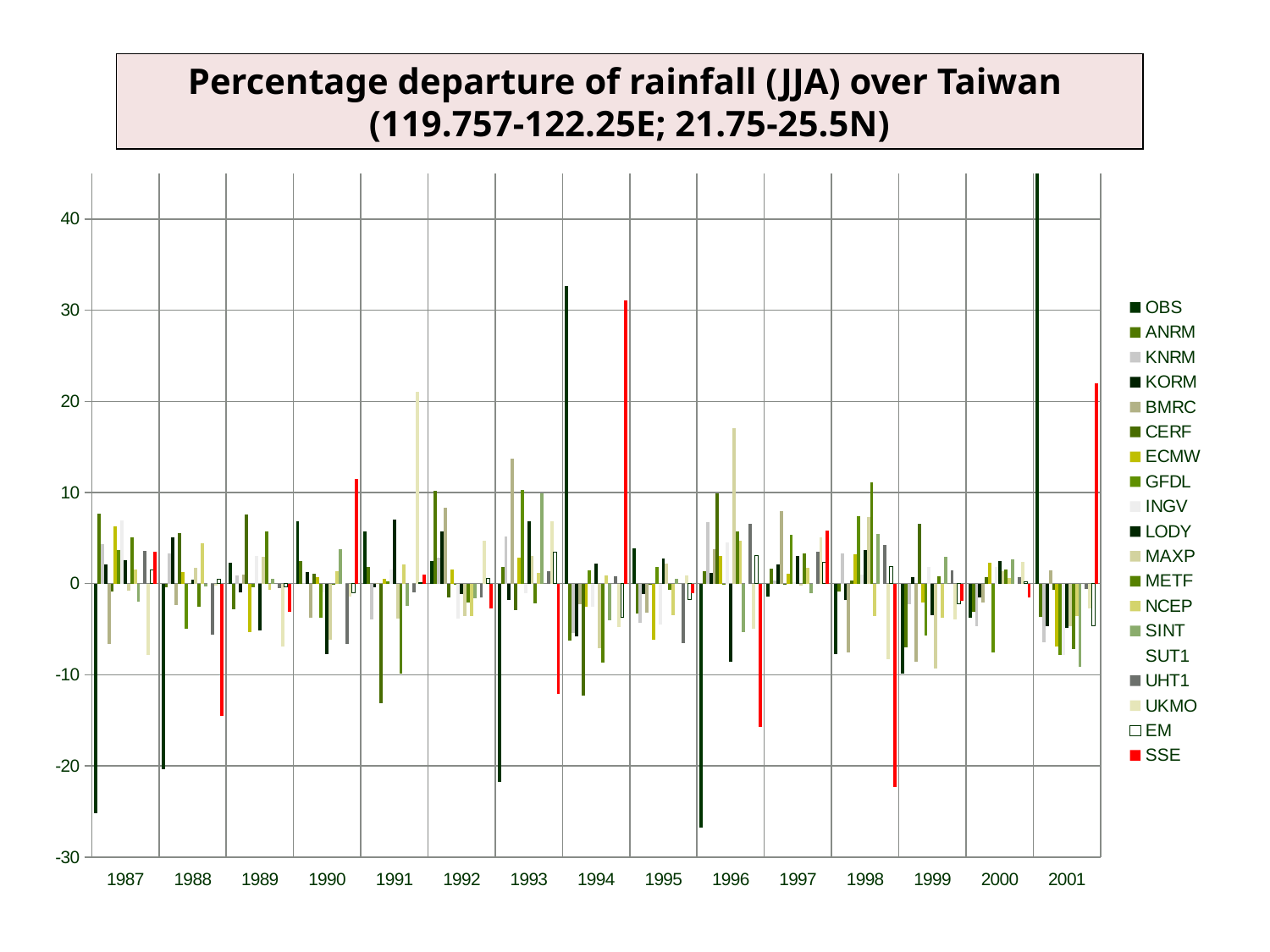
Is the SSE value for 2001 greater or less than 20? greater Which is larger, the SSE value for 1994 or the SSE value for 2001? 1994 Which year has the highest SSE value? 1994 What kind of chart is shown on the slide? bar chart Which series is drawn in red in the legend? SSE How many series does the legend list? 19 Is the OBS value for 1995 greater or less than -20? greater Is the OBS value for 2001 greater or less than 40? greater Which year has the highest OBS value? 2001 How many years are shown along the x axis? 15 Which year has the lowest SSE value? 1998